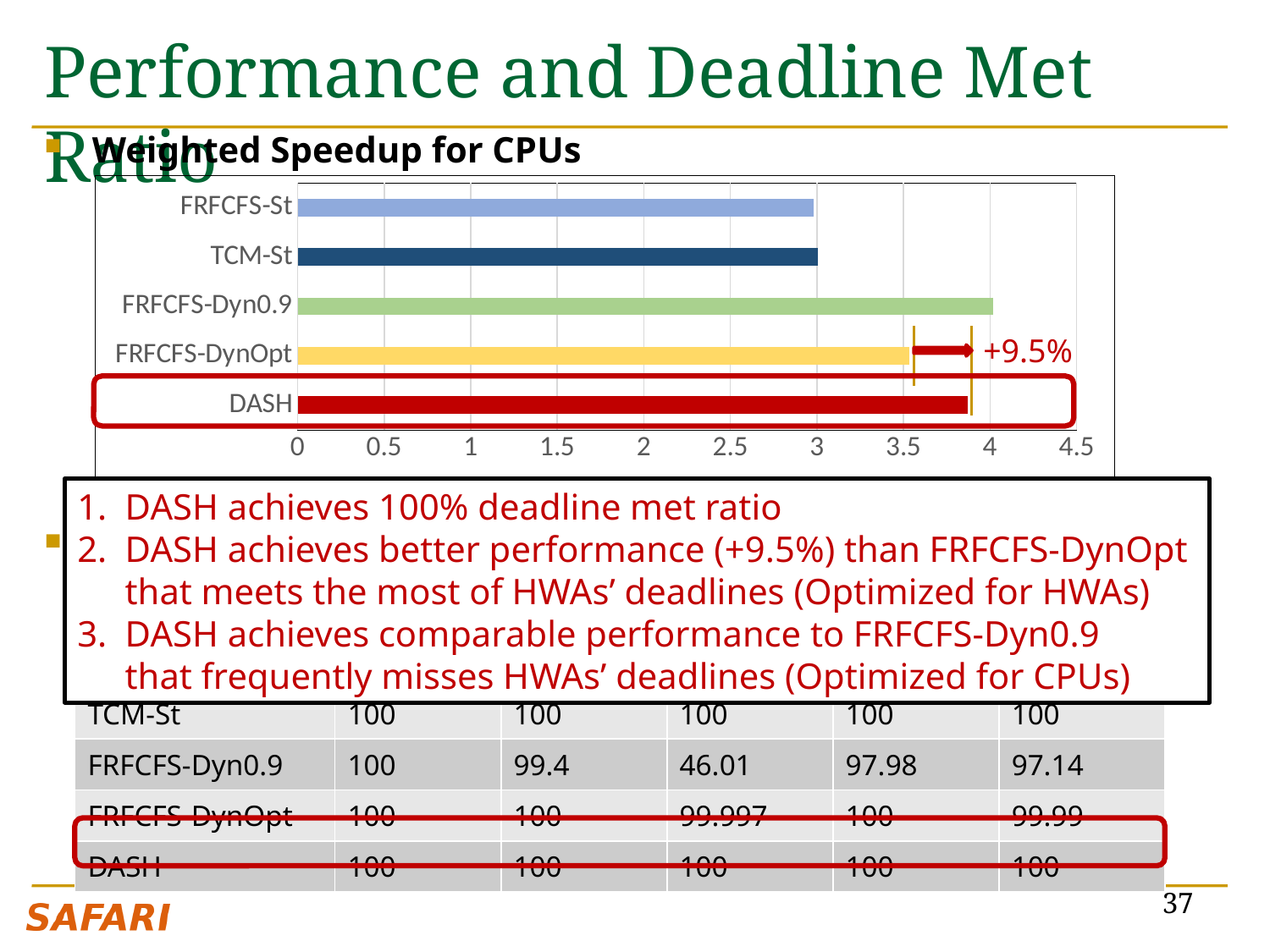
In the 'Weighted Speedup for CPUs' chart, is the value for FRFCFS-St greater or less than 3.5? less Which scheduler has the highest weighted speedup in the 'Weighted Speedup for CPUs' chart? FRFCFS-Dyn0.9 How many categories (schedulers) are plotted in the 'Weighted Speedup for CPUs' chart? 5 In the 'Weighted Speedup for CPUs' chart, is the value for TCM-St greater or less than 3.5? less In the 'Weighted Speedup for CPUs' chart, is the value for FRFCFS-Dyn0.9 greater or less than 3.5? greater In the 'Weighted Speedup for CPUs' chart, which has the larger weighted speedup, FRFCFS-Dyn0.9 or DASH? FRFCFS-Dyn0.9 What is the maximum value shown on the x axis of the 'Weighted Speedup for CPUs' chart? 4.5 What percentage improvement is annotated between FRFCFS-DynOpt and DASH in the 'Weighted Speedup for CPUs' chart? +9.5% What kind of chart is the 'Weighted Speedup for CPUs' chart? bar chart In the 'Weighted Speedup for CPUs' chart, which has the larger weighted speedup, DASH or FRFCFS-DynOpt? DASH